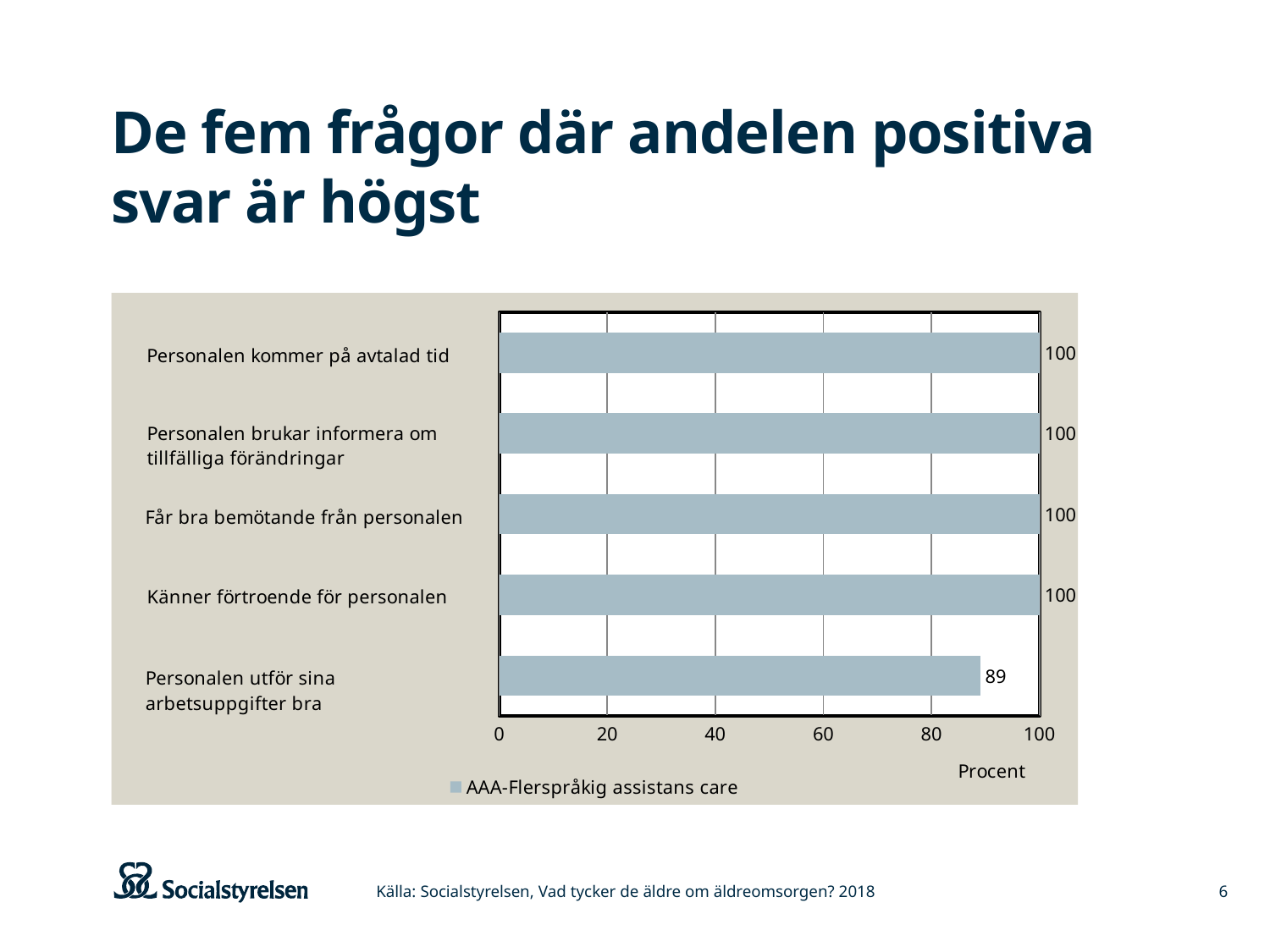
What is the series name shown in the legend? AAA-Flerspråkig assistans care What is the value for "Får bra bemötande från personalen"? 100 Is the value for "Personalen utför sina arbetsuppgifter bra" greater or less than 80? greater What is the value for "Personalen utför sina arbetsuppgifter bra"? 89 Which is larger: the value for "Känner förtroende för personalen" or the value for "Personalen utför sina arbetsuppgifter bra"? Känner förtroende för personalen How many categories are shown in the chart? 5 Which category has the lowest value? Personalen utför sina arbetsuppgifter bra What is the difference between the value for "Personalen kommer på avtalad tid" and the value for "Personalen utför sina arbetsuppgifter bra"? 11 How many series does the legend list? 1 What is the value for "Känner förtroende för personalen"? 100 What is the value for "Personalen kommer på avtalad tid"? 100 What kind of chart is shown on the slide? bar chart